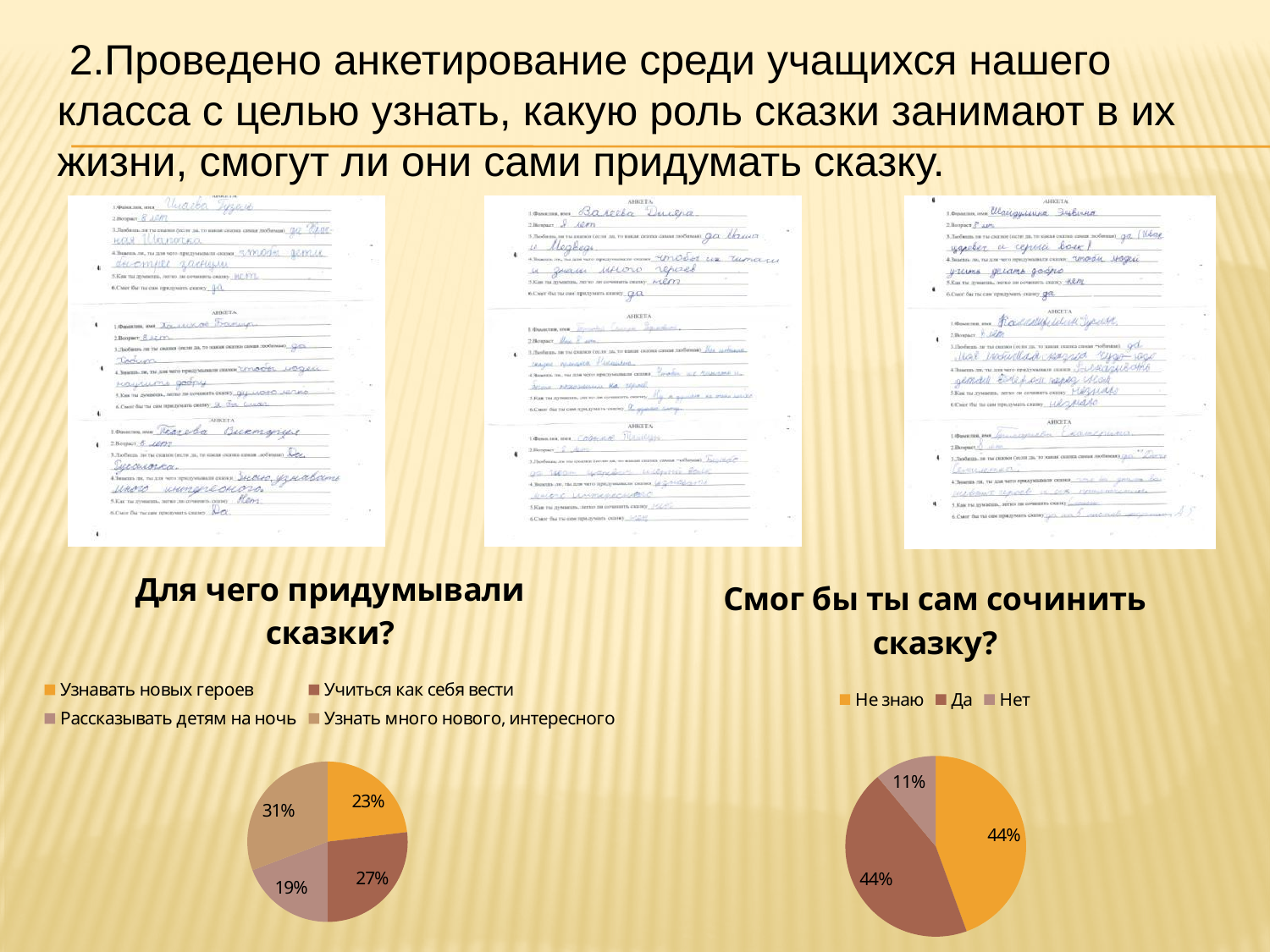
In the chart "Для чего придумывали сказки?", what share is shown for "Узнавать новых героев"? 23% What kind of chart is the chart titled "Для чего придумывали сказки?"? pie chart In the chart "Смог бы ты сам сочинить сказку?", what share is shown for "Да"? 44% In the chart "Для чего придумывали сказки?", what share is shown for "Учиться как себя вести"? 27% In the chart "Для чего придумывали сказки?", what is the difference between the shares for "Узнать много нового, интересного" and "Узнавать новых героев"? 8% In the chart "Для чего придумывали сказки?", which category has the largest share? Узнать много нового, интересного In the chart "Для чего придумывали сказки?", what share is shown for "Рассказывать детям на ночь"? 19% In the chart "Для чего придумывали сказки?", which category has the smallest share? Рассказывать детям на ночь In the chart "Смог бы ты сам сочинить сказку?", what share is shown for "Нет"? 11% How many categories does the legend of the chart "Смог бы ты сам сочинить сказку?" list? 3 How many categories does the legend of the chart "Для чего придумывали сказки?" list? 4 In the chart "Смог бы ты сам сочинить сказку?", which answer has the smallest share? Нет